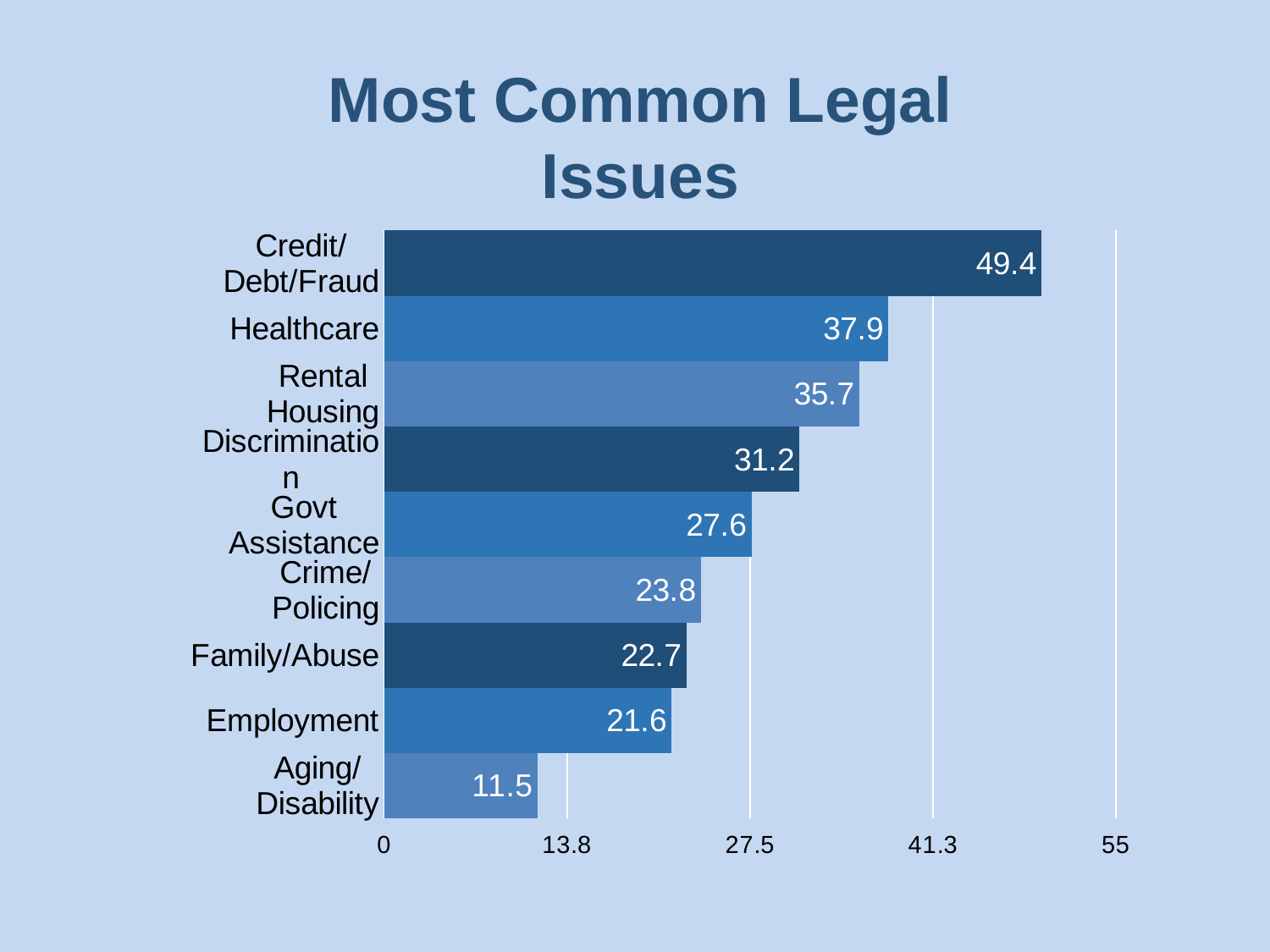
Which category has the highest value? Credit/Debt/Fraud What is the difference between the values for Credit/Debt/Fraud and Healthcare? 11.5 What is the value for Aging/Disability? 11.5 Which category has the lowest value? Aging/Disability Which is larger, the value for Govt Assistance or the value for Family/Abuse? Govt Assistance What is the difference between the values for Rental Housing and Discrimination? 4.5 Is the value for Employment greater or less than 27.5? less What kind of chart is shown on the slide? bar chart What is the value for Healthcare? 37.9 What is the value for Crime/Policing? 23.8 What is the title of the chart? Most Common Legal Issues How many categories are shown in the chart? 9